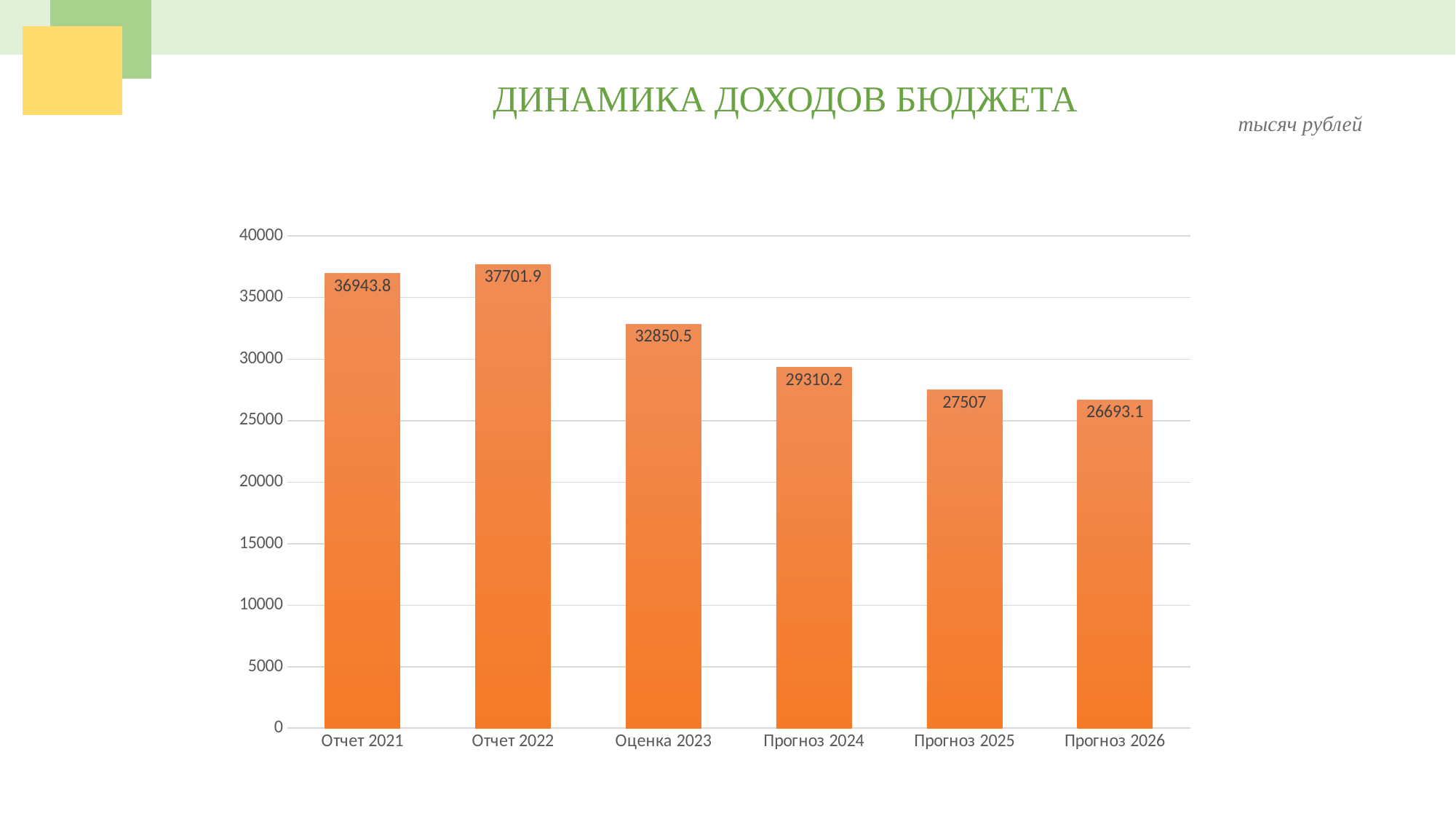
What is the value for Прогноз 2025? 27507 Which category has the lowest value? Прогноз 2026 Do the values rise or fall from Отчет 2022 to Прогноз 2026? fall Which is larger, the value for Прогноз 2024 or the value for Прогноз 2026? Прогноз 2024 What kind of chart is shown on the slide? bar chart Which category has the highest value? Отчет 2022 What is the value for Отчет 2021? 36943.8 Is the value for Прогноз 2025 greater or less than 30000? less What is the value for Оценка 2023? 32850.5 What is the difference between the values for Отчет 2022 and Отчет 2021? 758.1 What is the difference between the values for Оценка 2023 and Прогноз 2024? 3540.3 How many categories are shown on the x axis? 6